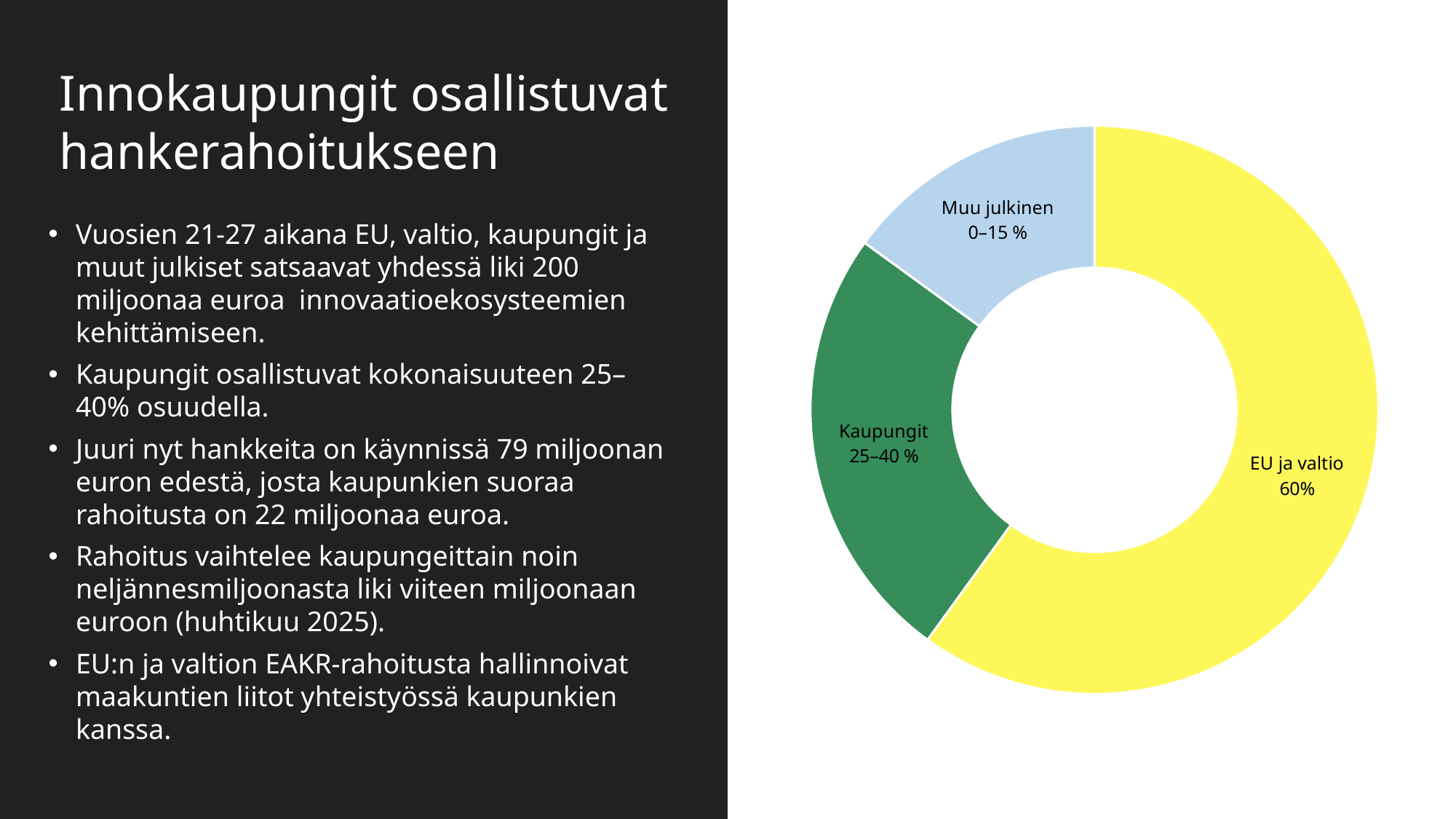
What colour is the Kaupungit slice in the donut chart? green What range is labelled for the Muu julkinen slice in the donut chart? 0–15 % What share of the donut chart does EU ja valtio take? 60% What share is labelled for the EU ja valtio slice in the donut chart? 60% Which slice is larger in the donut chart, EU ja valtio or Kaupungit? EU ja valtio Which slice of the donut chart is the largest? EU ja valtio How many slices does the donut chart have? 3 What kind of chart is shown on the slide? donut chart What colour is the EU ja valtio slice in the donut chart? yellow Which slice is larger in the donut chart, Kaupungit or Muu julkinen? Kaupungit Which slice of the donut chart is the smallest? Muu julkinen What range is labelled for the Kaupungit slice in the donut chart? 25–40 %